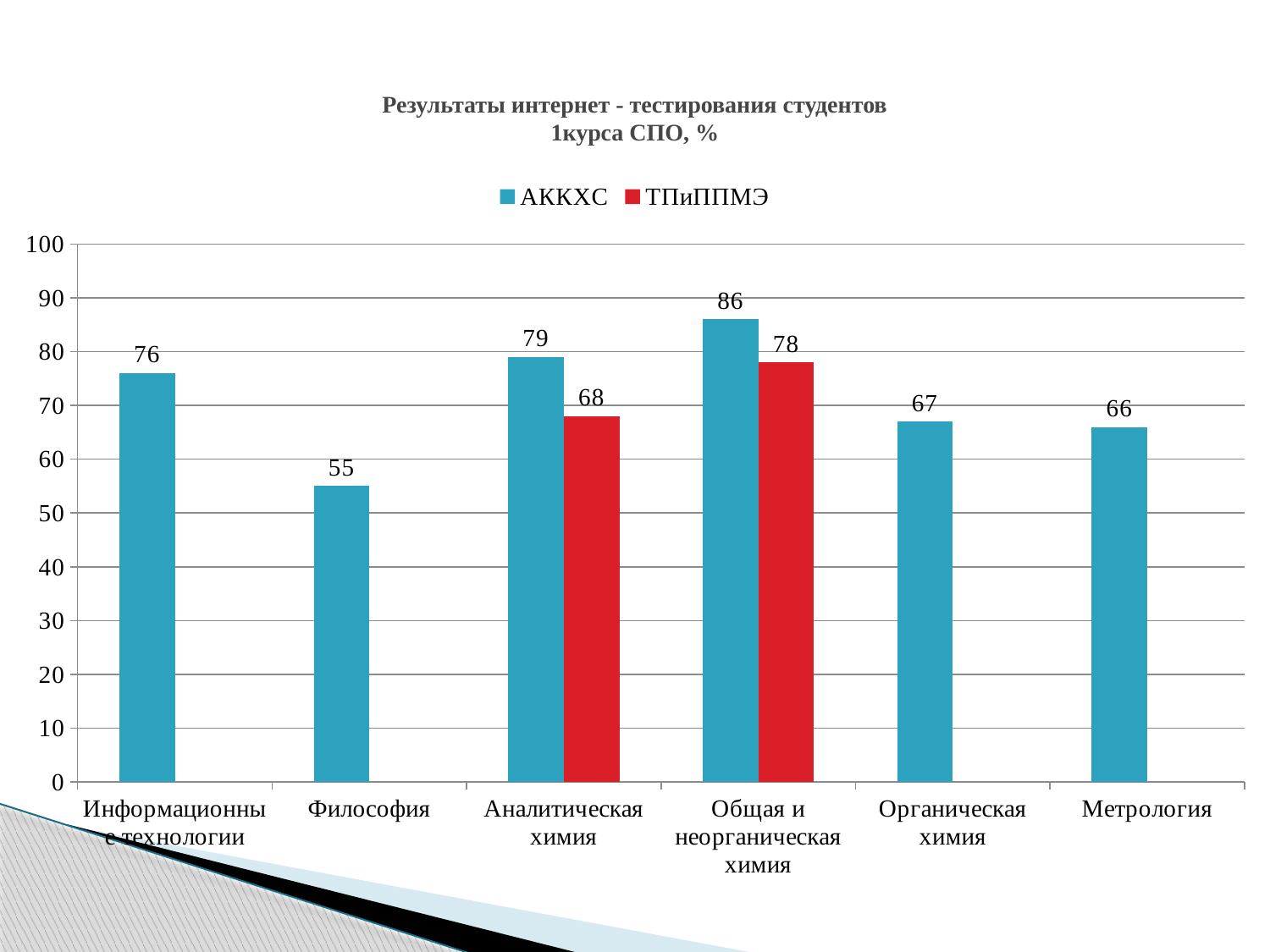
What kind of chart is shown on the slide? Bar chart Which category has the lowest value for АККХС? Философия What is the difference between АККХС and ТПиППМЭ in Общая и неорганическая химия? 8 Which is larger: the АККХС value for Информационные технологии or the АККХС value for Органическая химия? Информационные технологии How many categories are shown on the x axis? 6 Which category has the highest value for АККХС? Общая и неорганическая химия What is the value for ТПиППМЭ in Аналитическая химия? 68 How many series does the legend list? 2 What is the difference between АККХС and ТПиППМЭ in Аналитическая химия? 11 What is the value for АККХС in Метрология? 66 Which colour represents the ТПиППМЭ series? Red What is the value for АККХС in Философия? 55